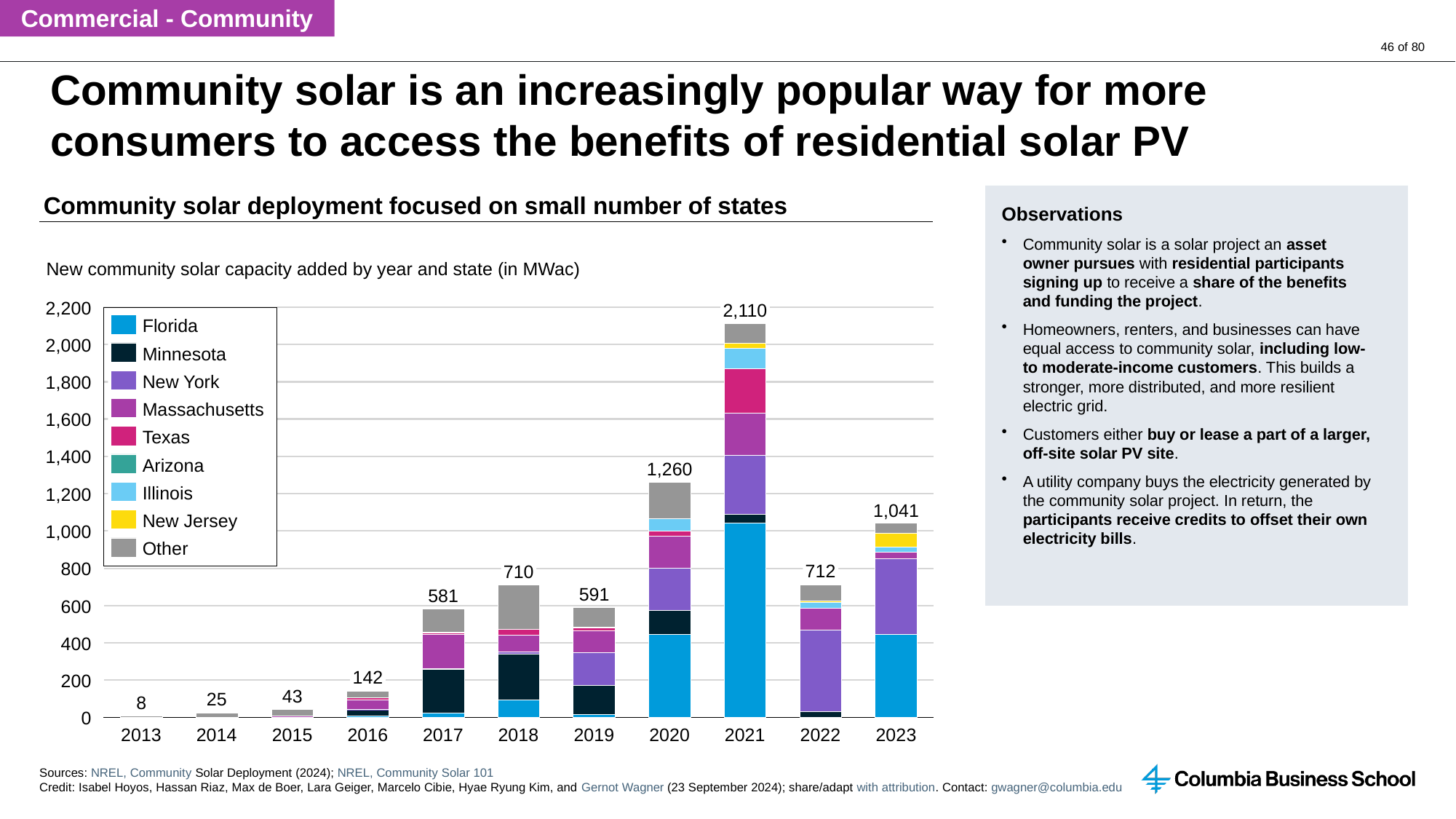
How many years are shown on the x axis of the chart? 11 What is the total new community solar capacity added in 2016? 142 What is the difference between the total capacity added in 2023 and in 2022? 329 What is the total new community solar capacity added in 2021? 2,110 How many series does the chart legend list? 9 Which colour represents Florida in the chart legend? Blue Which year has the lowest total new community solar capacity added? 2013 What is the difference between the total capacity added in 2021 and in 2020? 850 What kind of chart is shown on the slide? Stacked bar chart Is the Florida segment of the 2021 bar greater or less than 1,000? greater Which year has the highest total new community solar capacity added? 2021 Which year had a larger total capacity added, 2018 or 2019? 2018